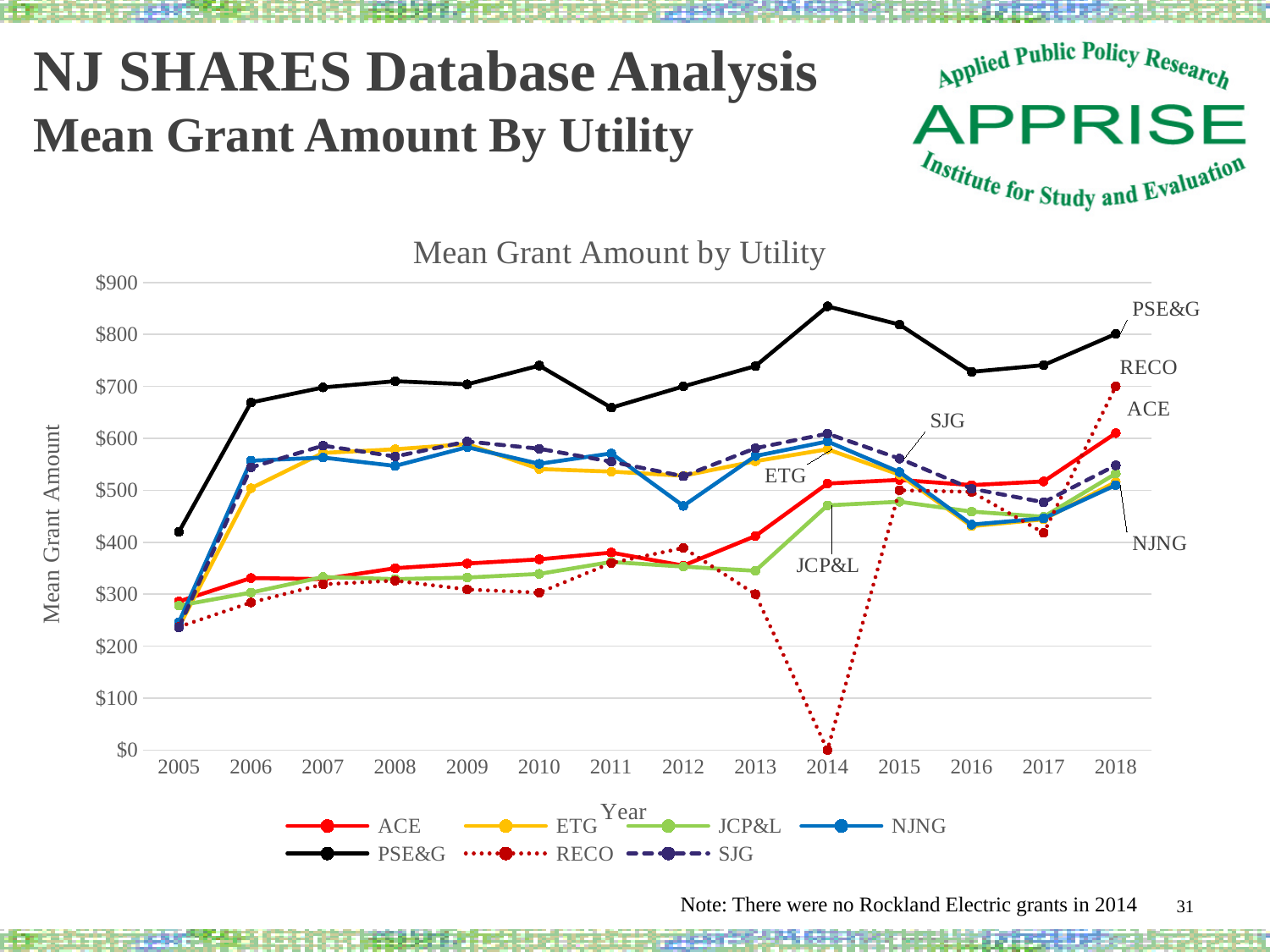
Is the value for NJNG in 2012 greater or less than $500? less How many series does the legend list? 7 Is the value for PSE&G in 2014 greater or less than $800? greater How many years are plotted along the x axis? 14 Does the PSE&G line rise or fall from 2005 to 2006? rise What is the mean grant amount for RECO in 2014? $0 Which utility has the lowest mean grant amount in 2014? RECO Which utility has the highest mean grant amount in 2014? PSE&G What kind of chart is shown on the slide? line chart Is the value for PSE&G in 2005 greater or less than $400? greater What is the title of the chart? Mean Grant Amount by Utility Which is larger in 2014, the value for ACE or the value for JCP&L? ACE